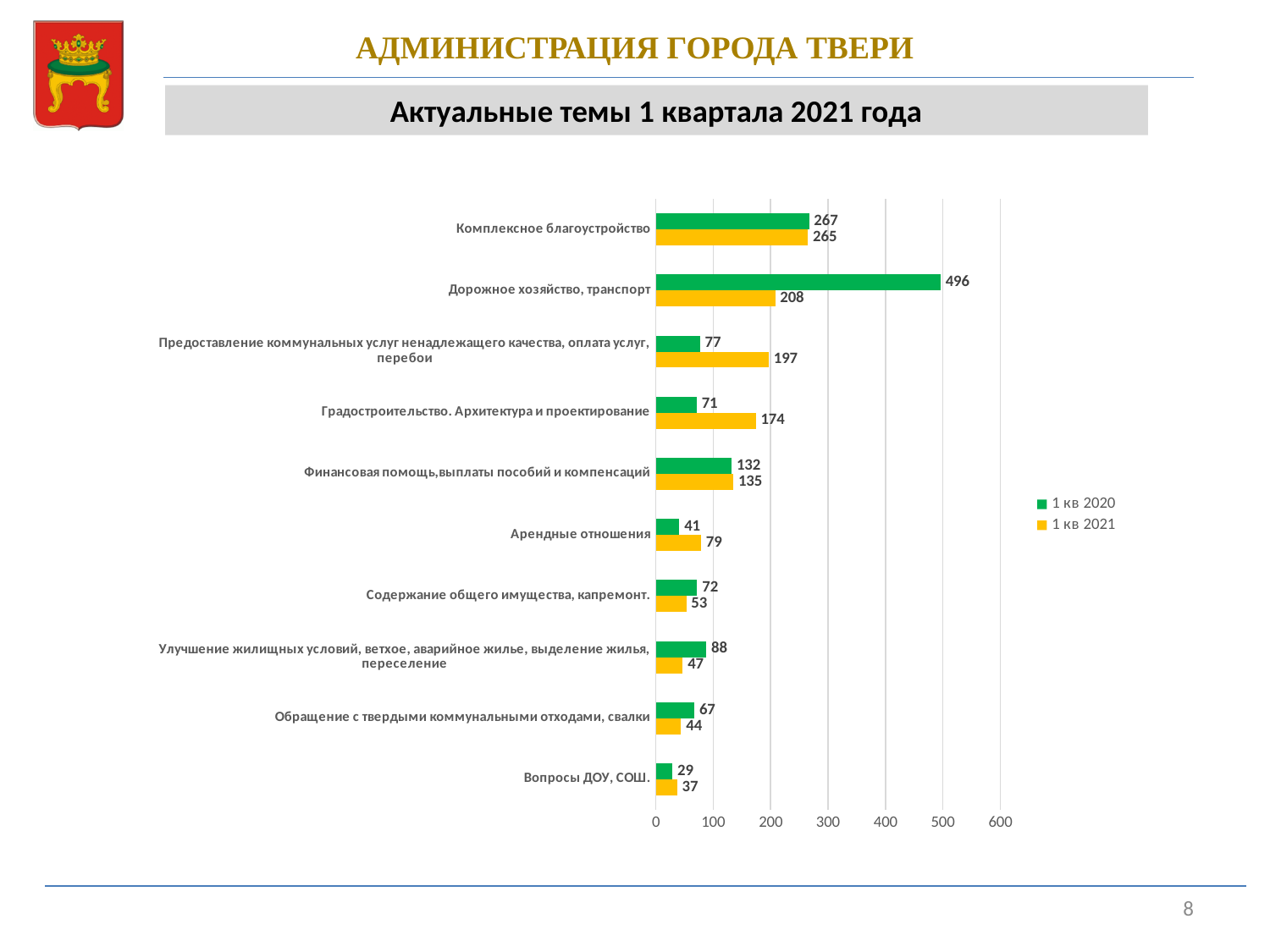
What is the title of the chart? Актуальные темы 1 квартала 2021 года What is the difference between the 1 кв 2020 and 1 кв 2021 values for Дорожное хозяйство, транспорт? 288 Is the 1 кв 2021 value for Комплексное благоустройство greater or less than 200? greater What is the value for Дорожное хозяйство, транспорт in the 1 кв 2020 series? 496 Which is larger for Арендные отношения: the 1 кв 2020 value or the 1 кв 2021 value? 1 кв 2021 What kind of chart is shown on the slide? bar chart What is the value for Градостроительство. Архитектура и проектирование in the 1 кв 2021 series? 174 How many series does the legend list? 2 What is the difference between the 1 кв 2021 and 1 кв 2020 values for Предоставление коммунальных услуг ненадлежащего качества, оплата услуг, перебои? 120 How many categories are shown on the chart? 10 Which category has the lowest value in the 1 кв 2021 series? Вопросы ДОУ, СОШ. Which category has the highest value in the 1 кв 2020 series? Дорожное хозяйство, транспорт